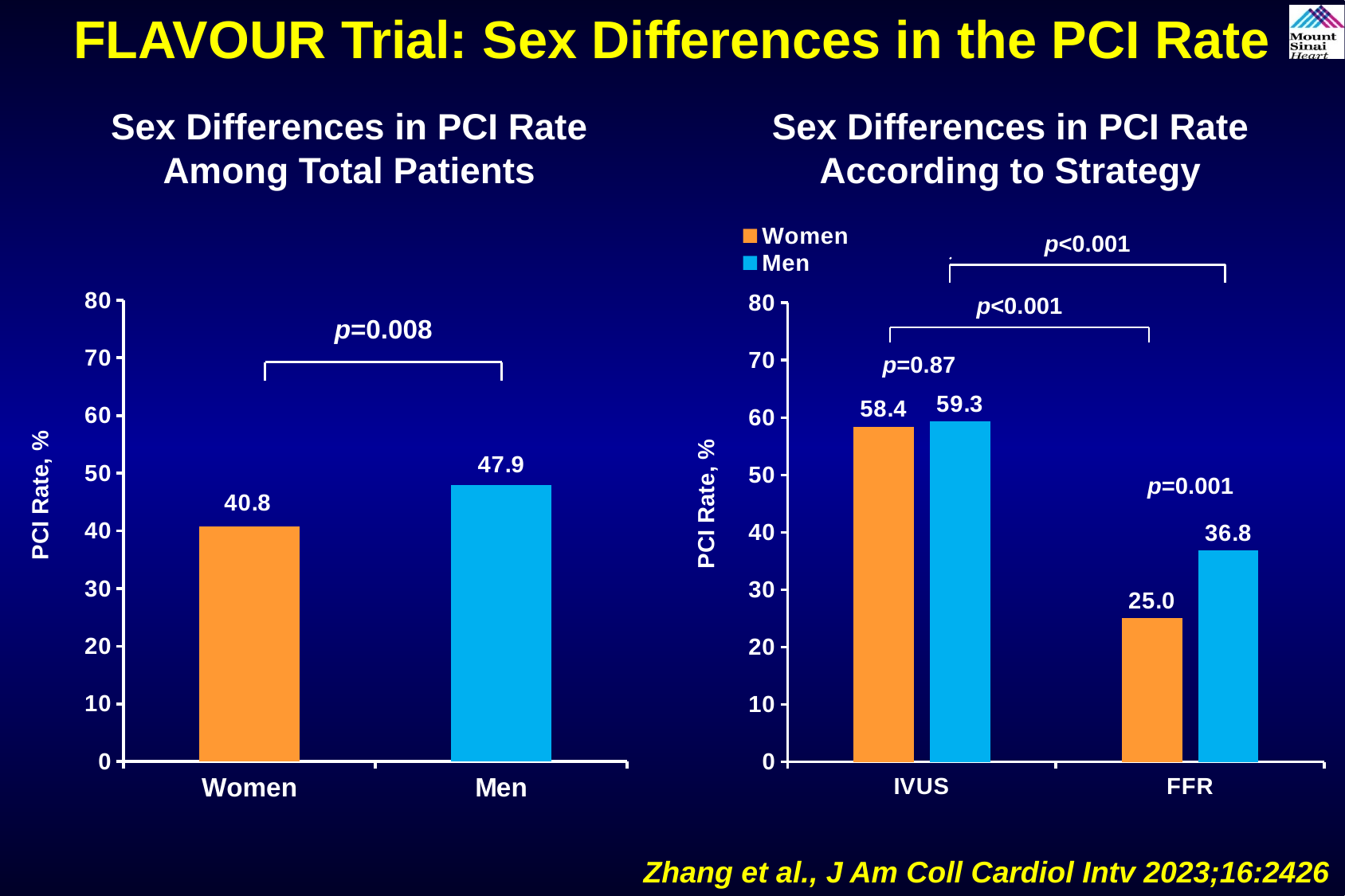
In the 'Sex Differences in PCI Rate According to Strategy' chart, what is the PCI rate for Women in the FFR group? 25.0 In the 'Sex Differences in PCI Rate Among Total Patients' chart, what is the PCI rate for Men? 47.9 In the 'Sex Differences in PCI Rate According to Strategy' chart, what is the PCI rate for Women in the IVUS group? 58.4 In the 'Sex Differences in PCI Rate Among Total Patients' chart, which group has the higher PCI rate, Women or Men? Men In the 'Sex Differences in PCI Rate According to Strategy' chart, what is the PCI rate for Men in the FFR group? 36.8 In the 'Sex Differences in PCI Rate Among Total Patients' chart, what is the PCI rate for Women? 40.8 In the 'Sex Differences in PCI Rate According to Strategy' chart, how many strategy categories are shown on the x axis? 2 In the 'Sex Differences in PCI Rate According to Strategy' chart, which bar has the lowest PCI rate? Women, FFR In the 'Sex Differences in PCI Rate Among Total Patients' chart, what is the difference between the PCI rate for Men and for Women? 7.1 In the 'Sex Differences in PCI Rate According to Strategy' chart, what is the difference between the Men and Women PCI rates in the FFR group? 11.8 What kind of chart is the 'Sex Differences in PCI Rate Among Total Patients' chart? Bar chart In the 'Sex Differences in PCI Rate According to Strategy' chart, how many series does the legend list? 2